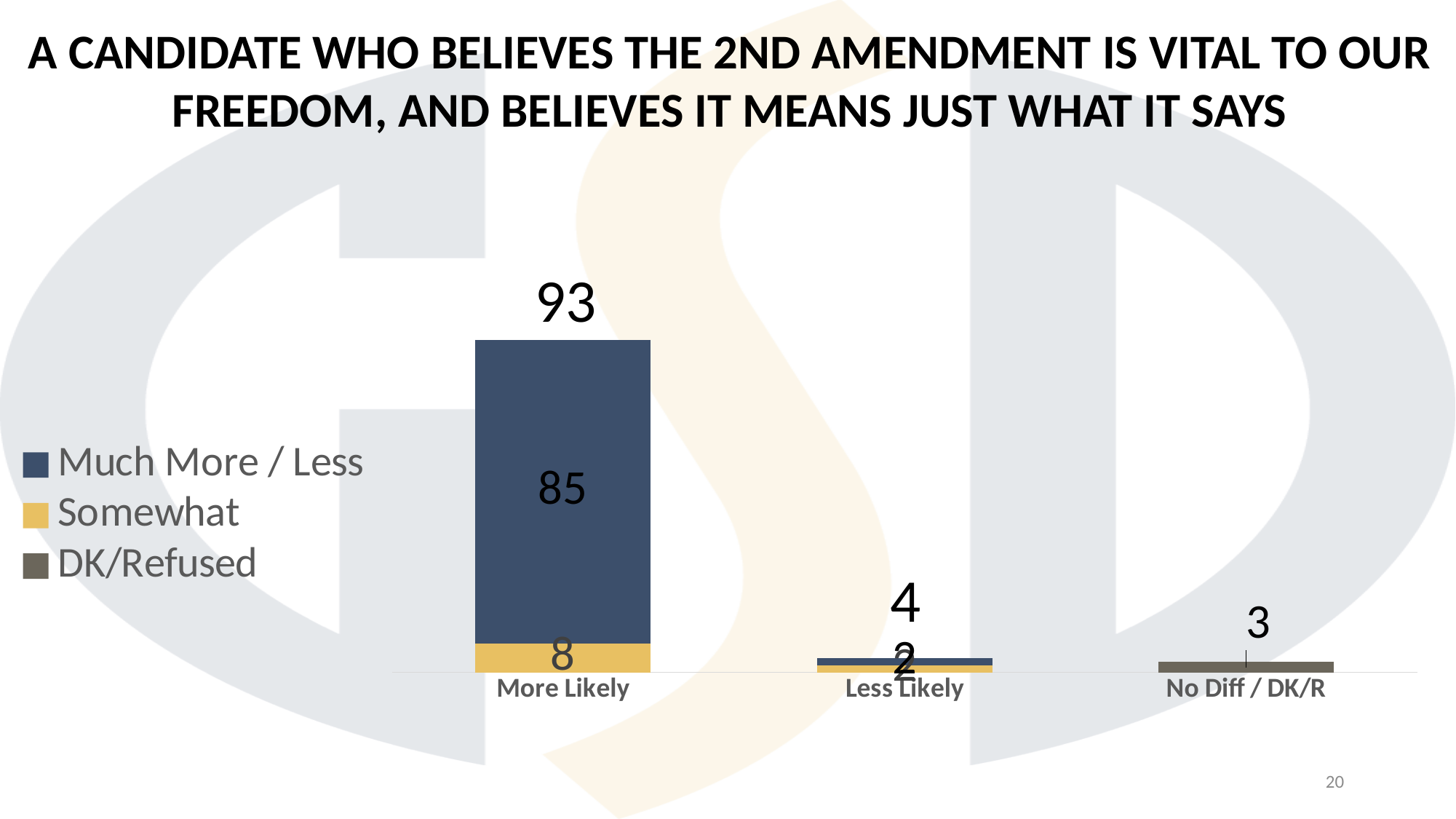
Which category has the highest total value? More Likely What is the value of the Somewhat segment for More Likely? 8 How many categories are shown along the x axis of the chart? 3 What kind of chart is shown on the slide? Bar chart What is the difference between the Much More / Less segment and the Somewhat segment for More Likely? 77 Which legend entry is shown in gold/yellow? Somewhat How many series does the chart's legend list? 3 What is the total of the stacked bar for Less Likely? 4 Which is larger, the total for Less Likely or the value for No Diff / DK/R? Less Likely What is the value for No Diff / DK/R? 3 What is the value of the Much More / Less segment for More Likely? 85 What is the total of the stacked bar for More Likely? 93